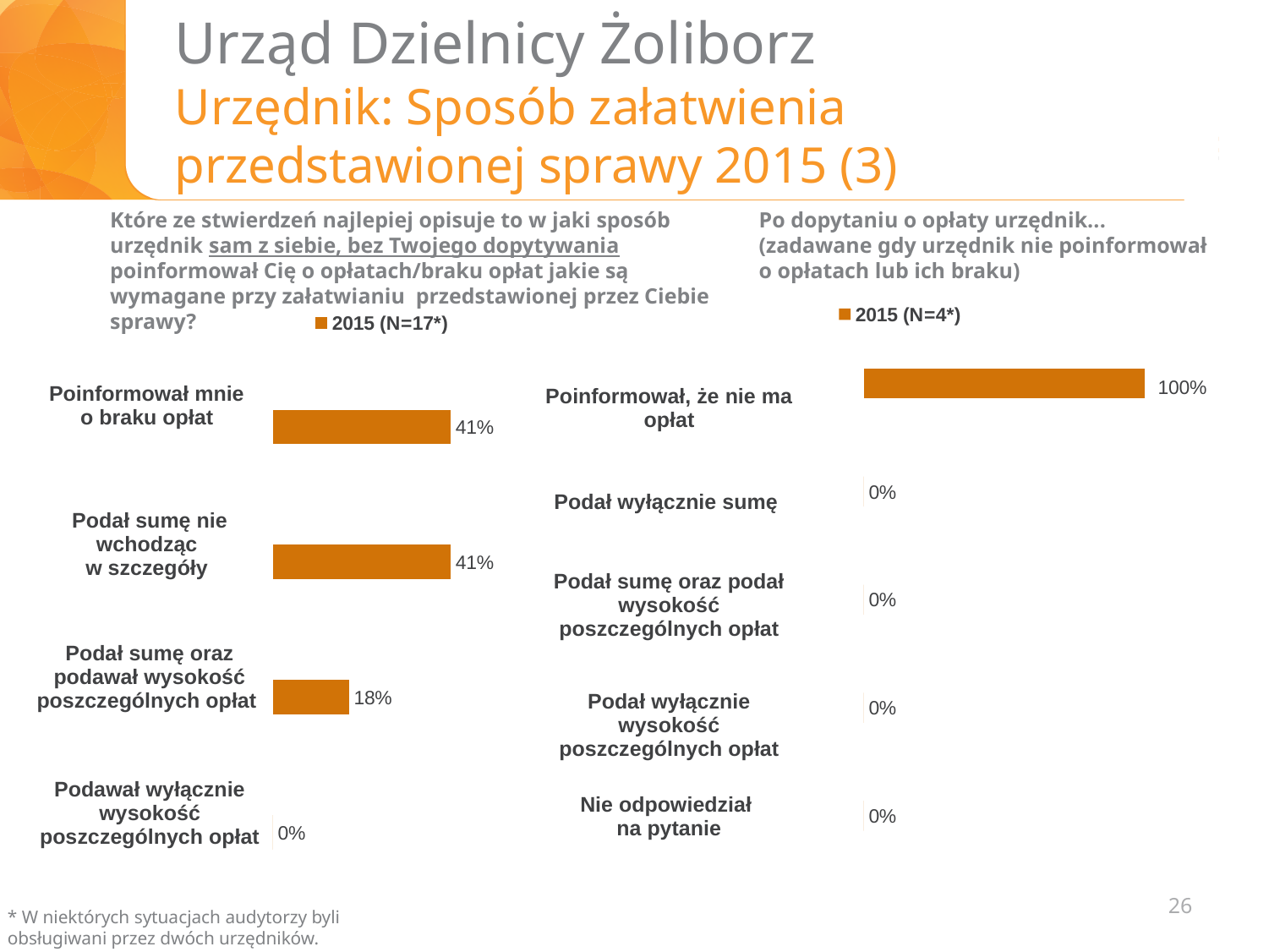
In the right chart, what is the value for "Podał wyłącznie sumę"? 0% In the left chart, what is the difference between the values for "Podał sumę nie wchodząc w szczegóły" and "Podał sumę oraz podawał wysokość poszczególnych opłat"? 23% How many categories does the right chart show? 5 How many categories does the left chart show? 4 In the right chart, what is the value for "Poinformował, że nie ma opłat"? 100% In the left chart, what is the value for "Poinformował mnie o braku opłat"? 41% In the left chart, which category has the lowest value? Podawał wyłącznie wysokość poszczególnych opłat In the left chart, what is the value for "Podawał wyłącznie wysokość poszczególnych opłat"? 0% In the left chart, which is larger: the value for "Poinformował mnie o braku opłat" or for "Podał sumę oraz podawał wysokość poszczególnych opłat"? Poinformował mnie o braku opłat What type of chart is the left chart? Bar chart In the left chart, what is the value for "Podał sumę oraz podawał wysokość poszczególnych opłat"? 18% In the right chart, which category has the highest value? Poinformował, że nie ma opłat